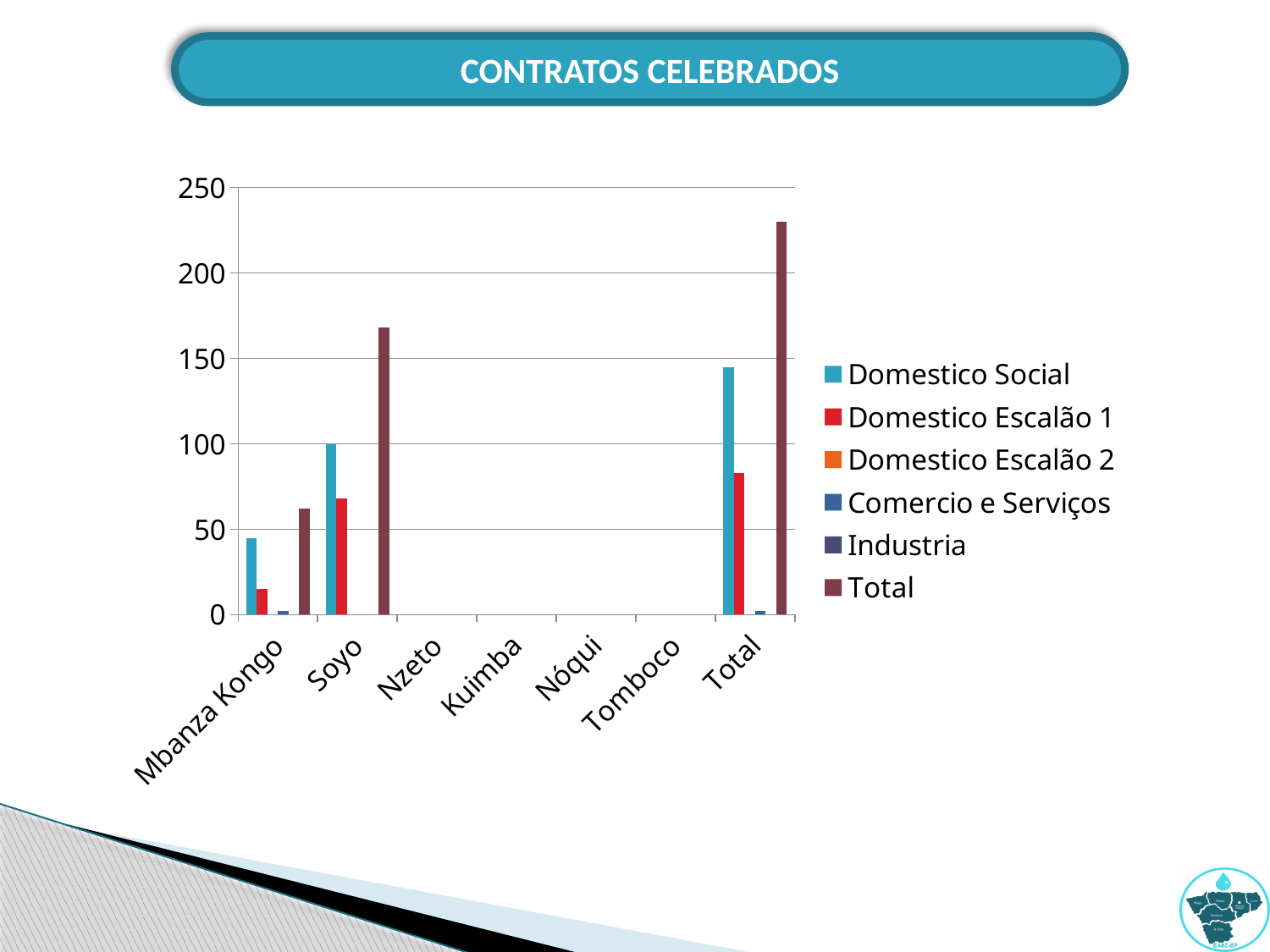
Is the Domestico Social value for Mbanza Kongo greater or less than 50? less What is the title of the chart? CONTRATOS CELEBRADOS How many series does the legend list? 6 Is the Domestico Escalão 1 value for the Total category greater or less than 100? less Is the Domestico Escalão 1 value for Soyo greater or less than 50? greater Which has the larger Domestico Social value, Soyo or Mbanza Kongo? Soyo How many categories are shown on the x axis? 7 Which has the larger Total value, Soyo or Mbanza Kongo? Soyo Which category has the highest Total bar? Total What kind of chart is shown on the slide? bar chart